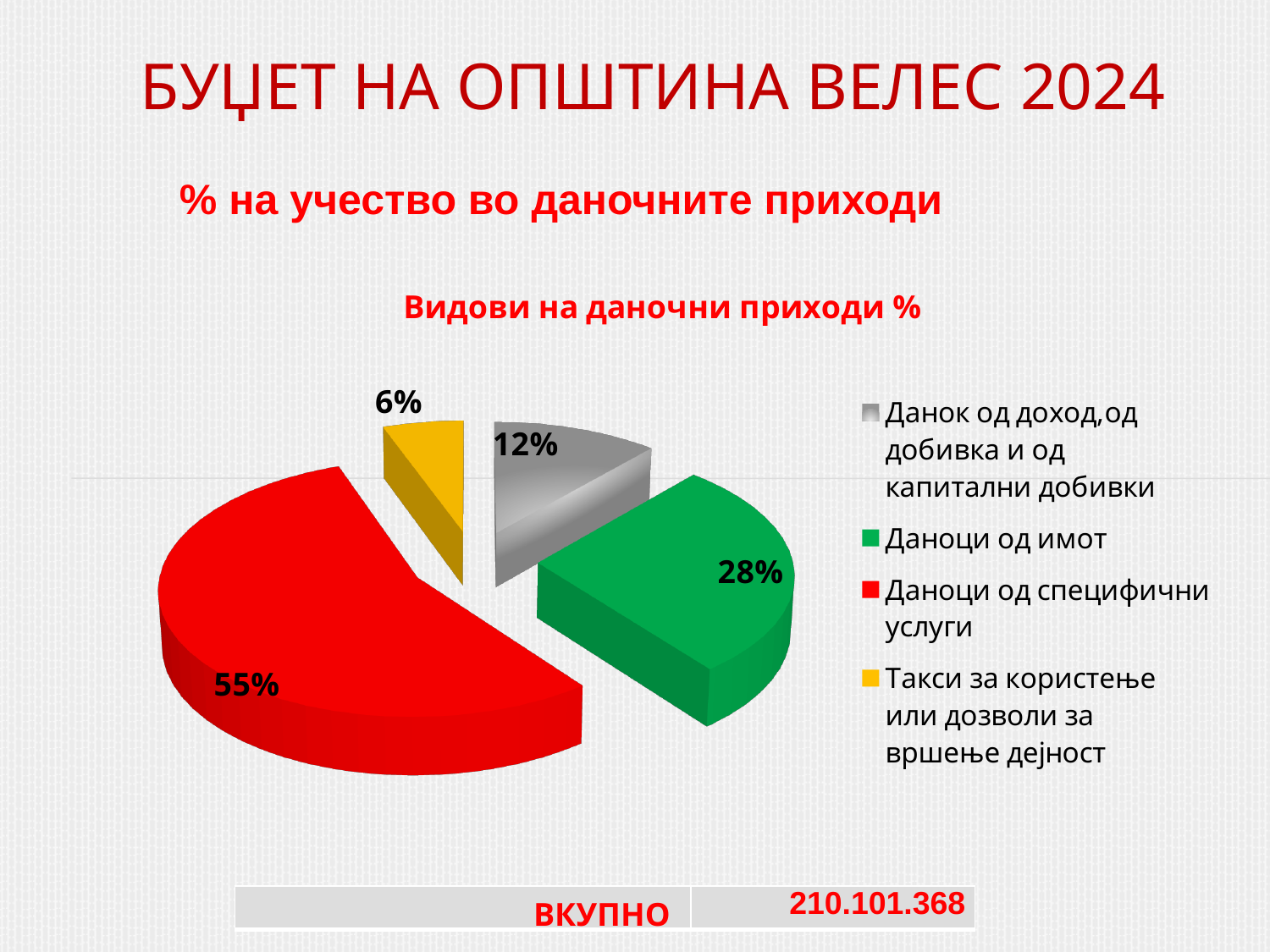
Which category has the largest slice of the pie? Даноци од специфични услуги What is the difference in percentage points between 'Даноци од специфични услуги' and 'Даноци од имот'? 27 Which is larger: 'Даноци од имот' or 'Данок од доход,од добивка и од капитални добивки'? Даноци од имот What share of the pie is 'Даноци од имот'? 28% What type of chart is shown on the slide? Pie chart What share of the pie is 'Данок од доход,од добивка и од капитални добивки'? 12% What share of the pie is 'Такси за користење или дозволи за вршење дејност'? 6% What is the chart's title? Видови на даночни приходи % How many slices does the pie chart have? 4 Which category has the smallest slice of the pie? Такси за користење или дозволи за вршење дејност What colour is the slice for 'Даноци од имот'? Green